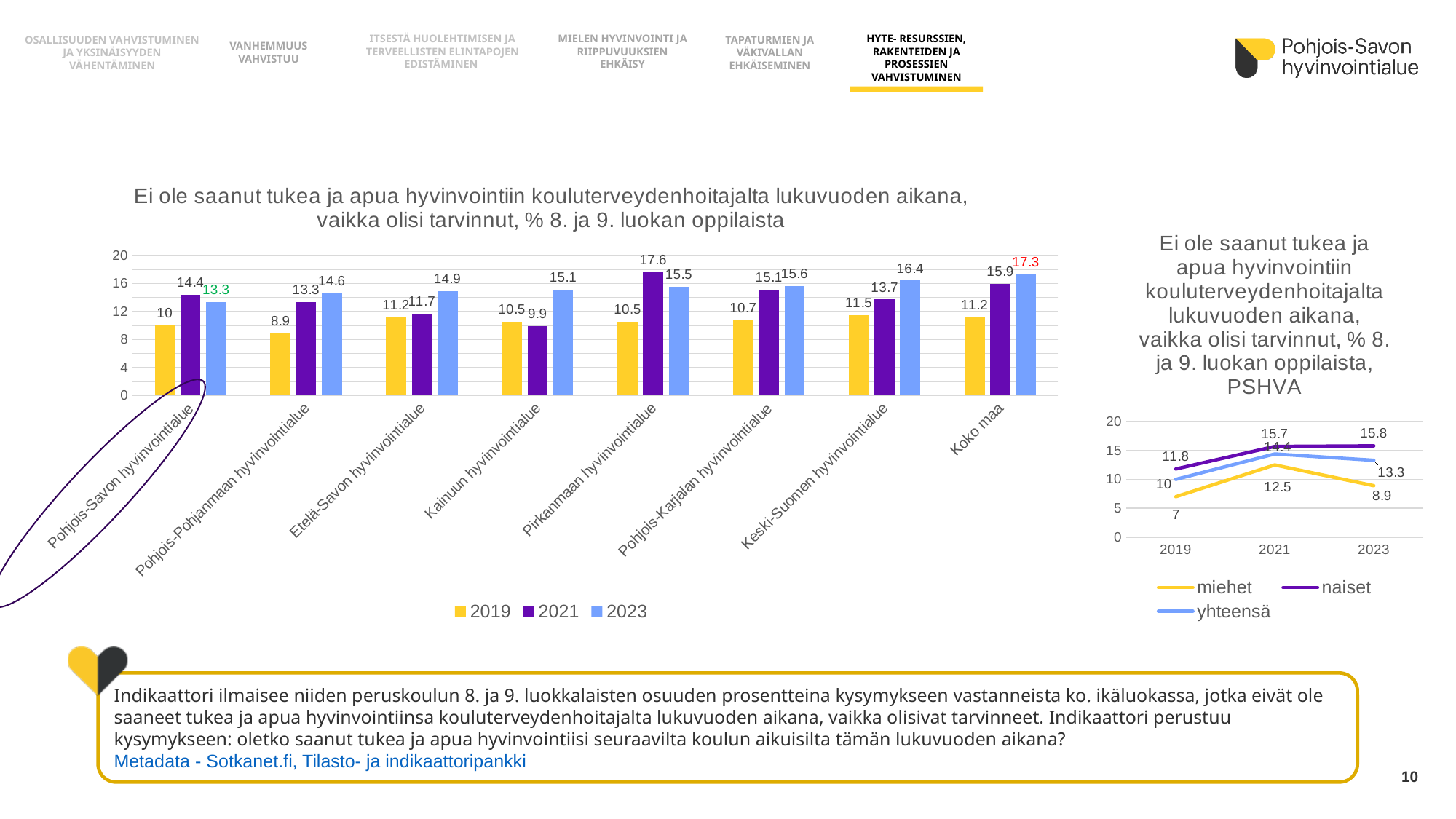
In the left bar chart, what is the difference between the 2023 and 2019 values for Kainuun hyvinvointialue? 4.6 In the right line chart (PSHVA), what is the difference between naiset and miehet in 2023? 6.9 In the right line chart (PSHVA), does the miehet line rise or fall from 2021 to 2023? Fall What kind of chart is the chart on the right (PSHVA)? Line chart In the left bar chart, what is the 2023 value for Koko maa? 17.3 In the left bar chart, which region has the highest 2021 value? Pirkanmaan hyvinvointialue In the left bar chart, what is the 2021 value for Pohjois-Savon hyvinvointialue? 14.4 In the left bar chart, which region has the lowest 2019 value? Pohjois-Pohjanmaan hyvinvointialue How many series does the legend of the left bar chart list? 3 How many regions (categories) are shown on the x axis of the left bar chart? 8 In the left bar chart, which is larger for Pohjois-Savon hyvinvointialue: the 2021 value or the 2023 value? 2021 In the right line chart (PSHVA), what is the value for miehet in 2021? 12.5